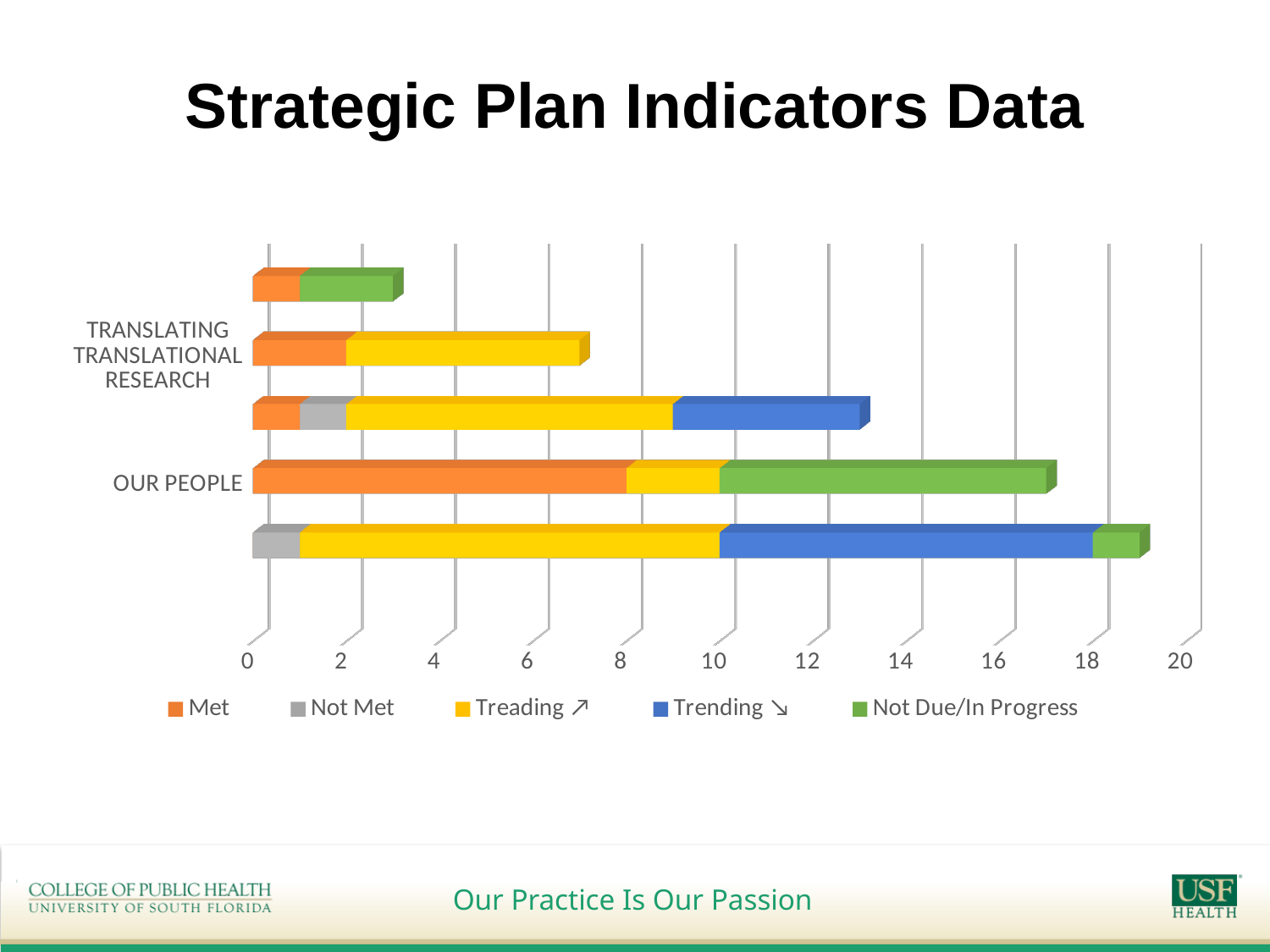
How many series does the legend list? 5 How many stacked bars are plotted in the chart? 5 Is the total length of the OUR PEOPLE bar greater or less than 16? greater Is the total length of the OUR PEOPLE bar greater or less than 18? less Is the 'Met' segment of the OUR PEOPLE bar greater or less than 6? greater Which colour represents the 'Met' series in the legend? Orange Which has the longer total bar, OUR PEOPLE or TRANSLATING TRANSLATIONAL RESEARCH? OUR PEOPLE What is the title of the slide containing the chart? Strategic Plan Indicators Data What kind of chart is shown on the slide? Bar chart